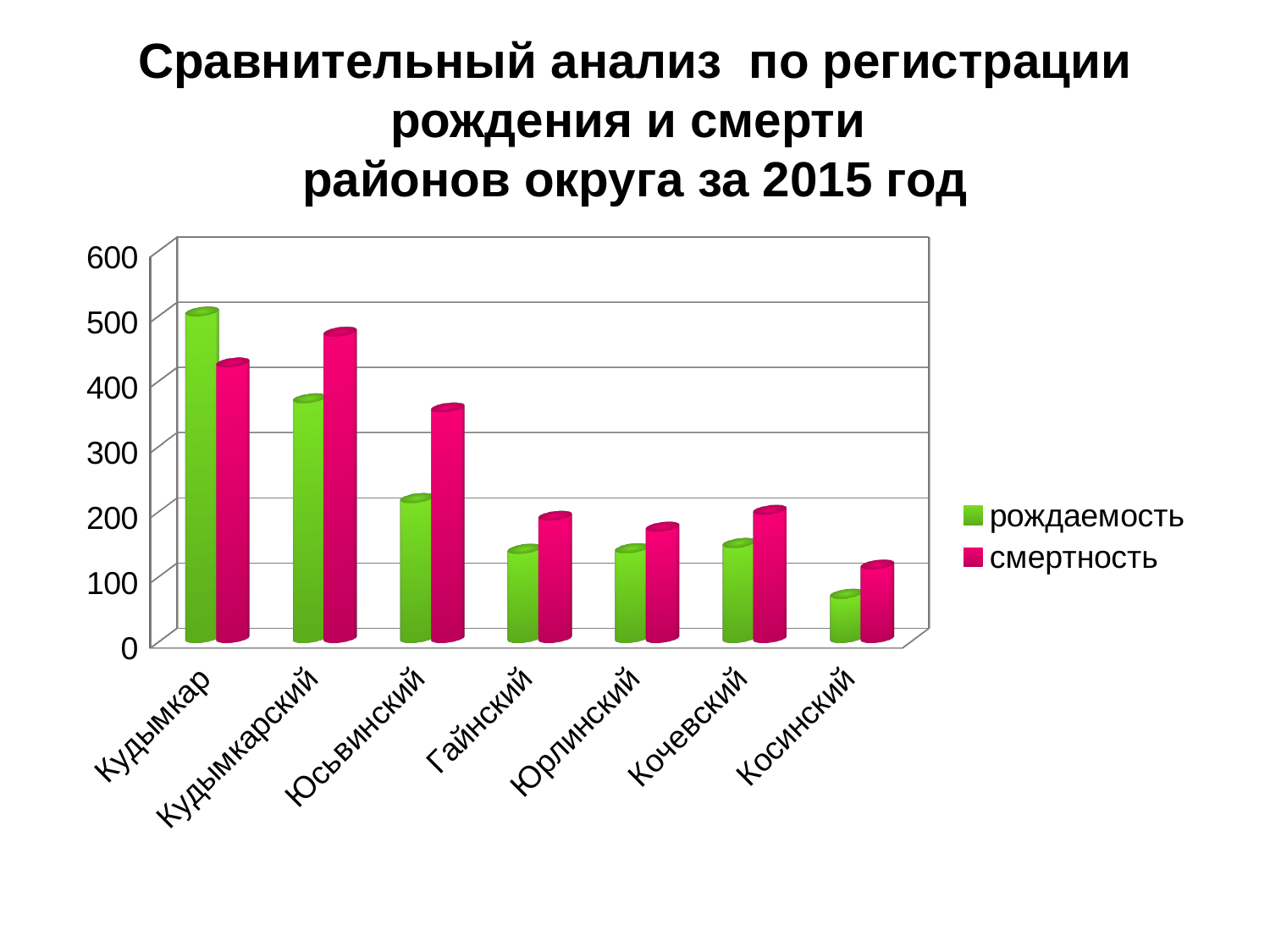
Which district has the highest рождаемость value? Кудымкар Which district has the highest смертность value? Кудымкарский What kind of chart is shown on the slide? bar chart Which colour represents смертность in the legend? pink Is the рождаемость value for Кудымкар greater or less than 400? greater For Кудымкарский, which is larger: рождаемость or смертность? смертность For Кудымкар, which is larger: рождаемость or смертность? рождаемость Which district has the lowest рождаемость value? Косинский Which district has the lowest смертность value? Косинский How many districts (categories) are shown on the x axis? 7 Is the рождаемость value for Косинский greater or less than 100? less How many series does the legend list? 2